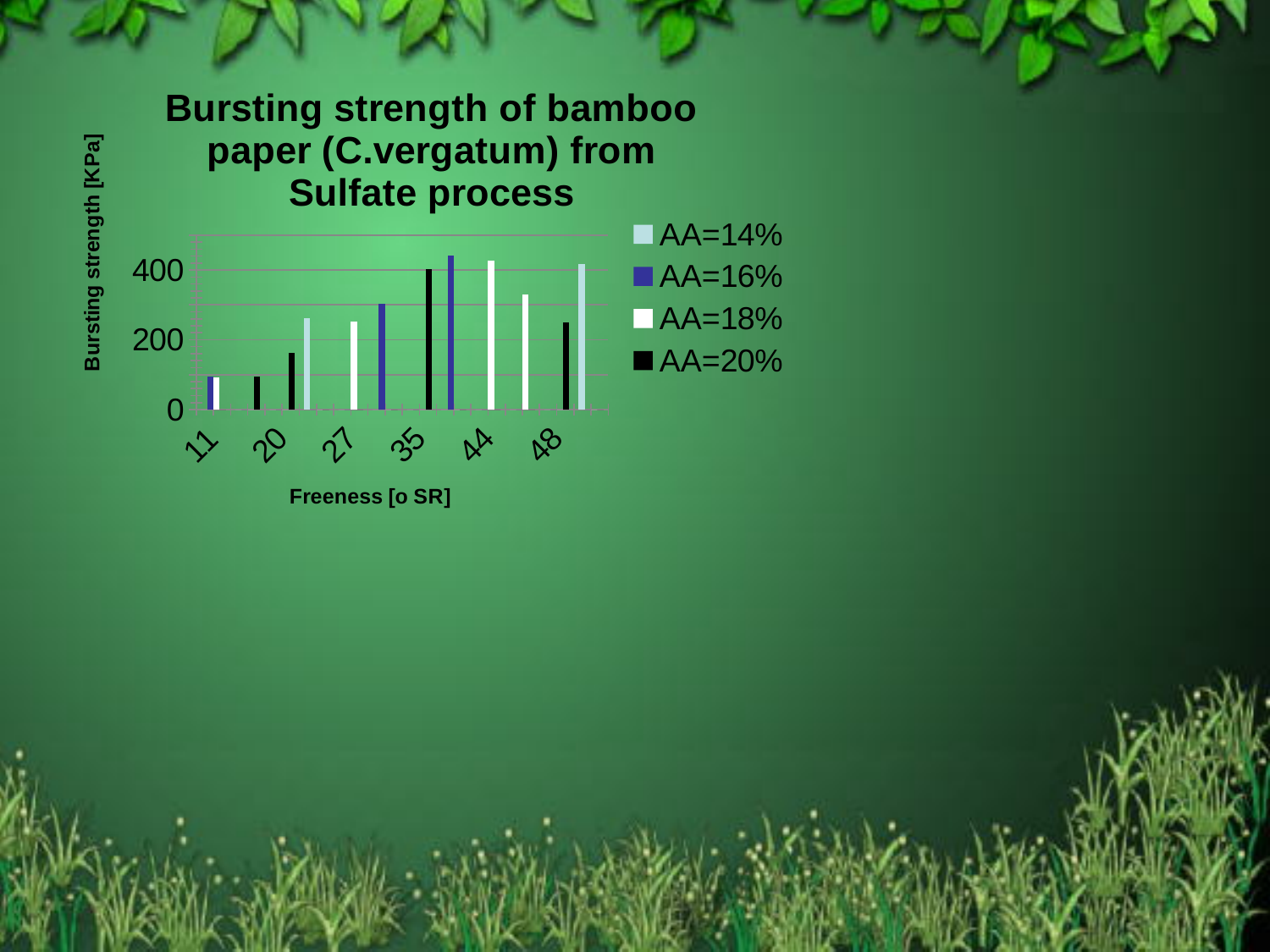
Is the shortest bar on the chart greater or less than 200? less How many series does the legend list? 4 Is the tallest bar on the chart greater or less than 400? greater Which series are listed in the legend? AA=14%, AA=16%, AA=18%, AA=20% How many freeness categories are labelled on the x axis? 6 What is the title of the chart? Bursting strength of bamboo paper (C.vergatum) from Sulfate process What kind of chart is shown on the slide? Bar chart